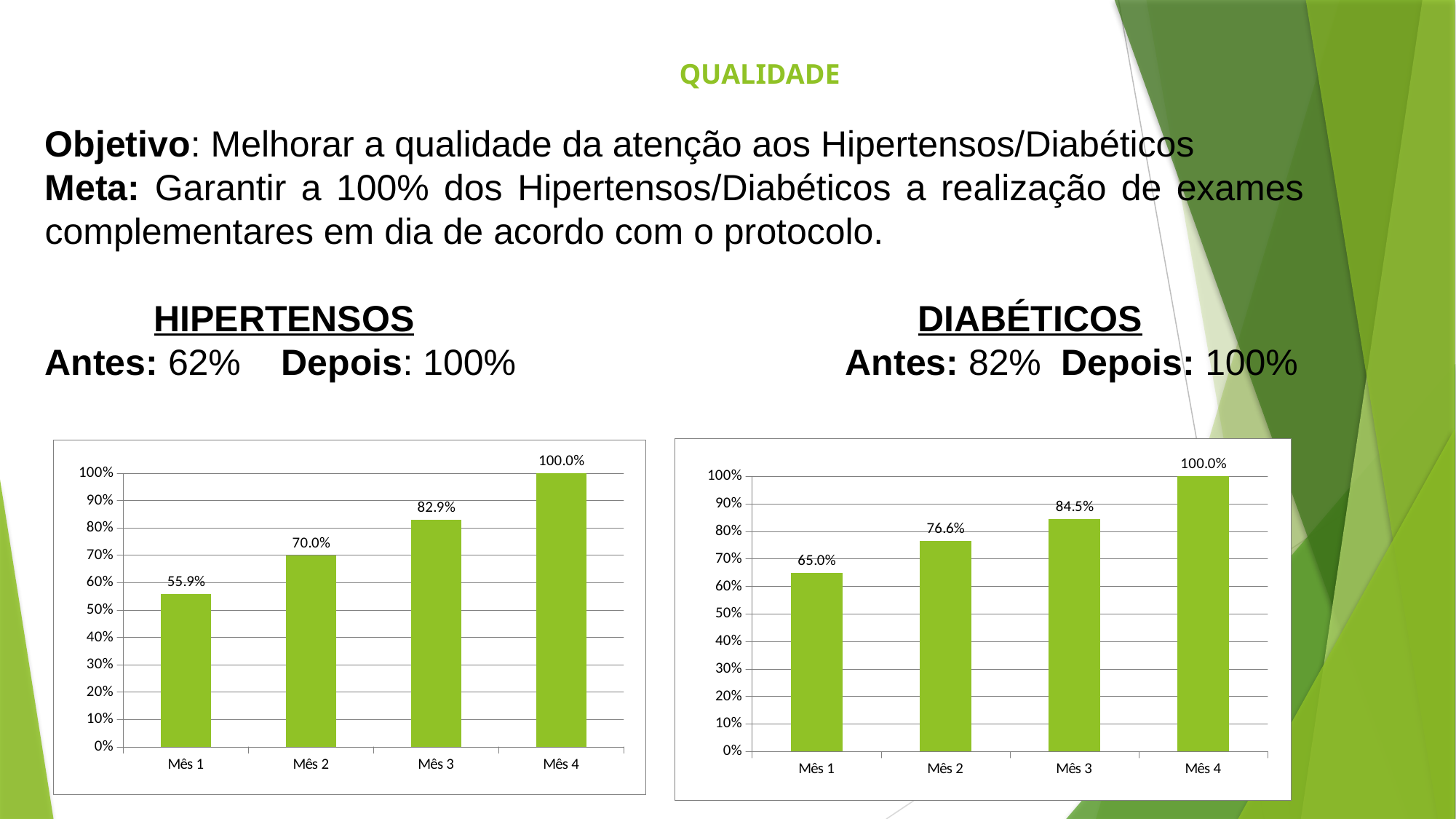
In the right chart (Diabéticos), which month has the highest value? Mês 4 In the right chart (Diabéticos), what is the difference between the values for Mês 4 and Mês 1? 35.0% In the right chart (Diabéticos), do the values rise or fall from Mês 1 to Mês 4? Rise How many months are plotted in the left chart (Hipertensos)? 4 What kind of chart is the right chart (Diabéticos)? Bar chart In the left chart (Hipertensos), what is the difference between the values for Mês 2 and Mês 1? 14.1% In the left chart (Hipertensos), which month has the lowest value? Mês 1 In the left chart (Hipertensos), what is the value for Mês 1? 55.9% Which is larger: the Mês 1 value in the left chart (Hipertensos) or the Mês 1 value in the right chart (Diabéticos)? Right chart (Diabéticos), 65.0% In the right chart (Diabéticos), what is the value for Mês 2? 76.6% In the left chart (Hipertensos), what is the value for Mês 3? 82.9% In the right chart (Diabéticos), what is the value for Mês 3? 84.5%